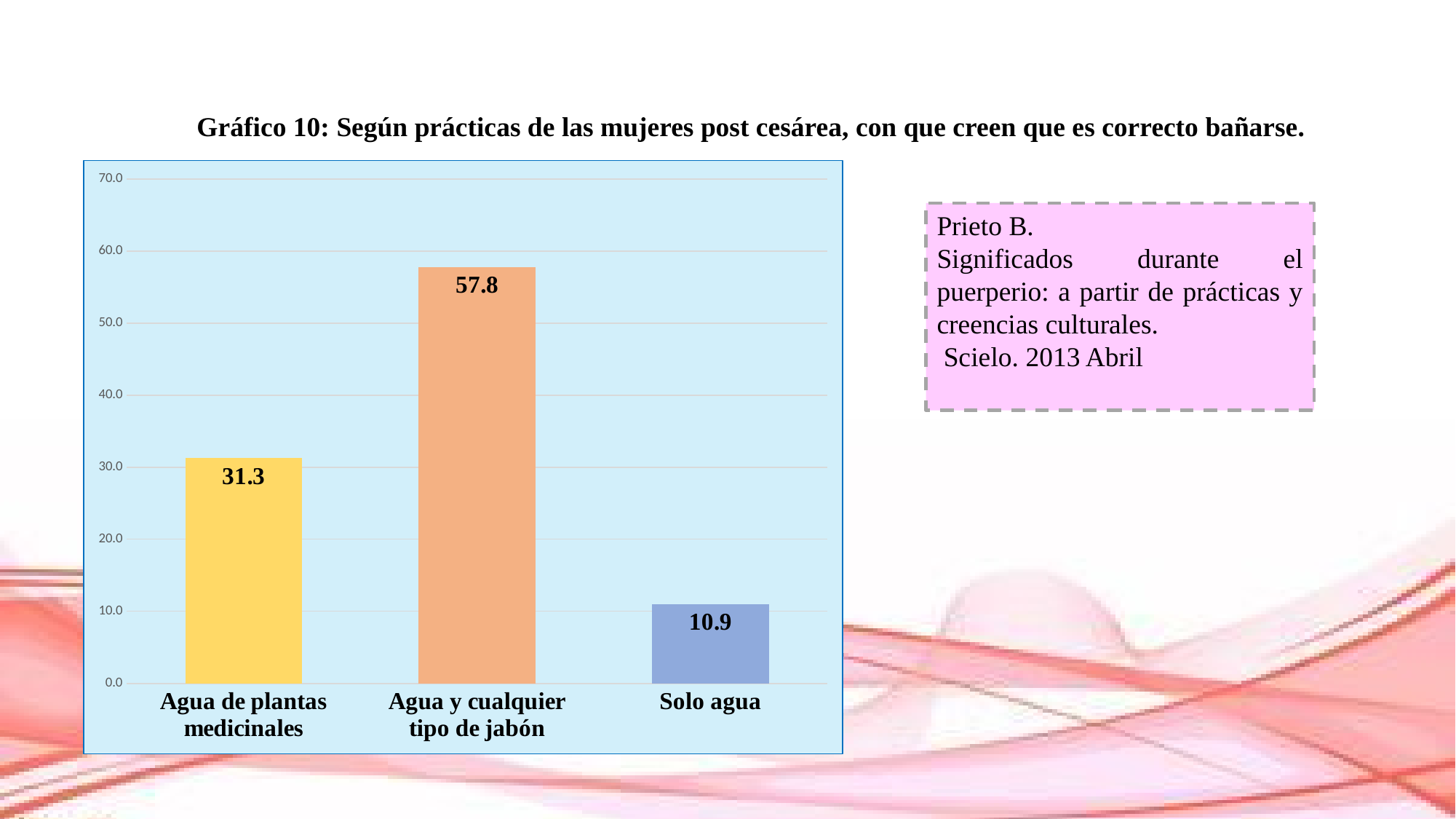
Is the value for "Agua y cualquier tipo de jabón" greater or less than 50.0? greater What is the difference between the values for "Agua y cualquier tipo de jabón" and "Agua de plantas medicinales"? 26.5 What is the value for "Agua y cualquier tipo de jabón"? 57.8 What is the value for "Solo agua"? 10.9 What is the value for "Agua de plantas medicinales"? 31.3 What is the title of the chart? Gráfico 10: Según prácticas de las mujeres post cesárea, con que creen que es correcto bañarse. Which category has the highest value? Agua y cualquier tipo de jabón Which category has the lowest value? Solo agua Which is larger, the value for "Agua de plantas medicinales" or the value for "Solo agua"? Agua de plantas medicinales What is the difference between the values for "Agua de plantas medicinales" and "Solo agua"? 20.4 How many categories are shown in the chart? 3 What kind of chart is shown on the slide? Bar chart